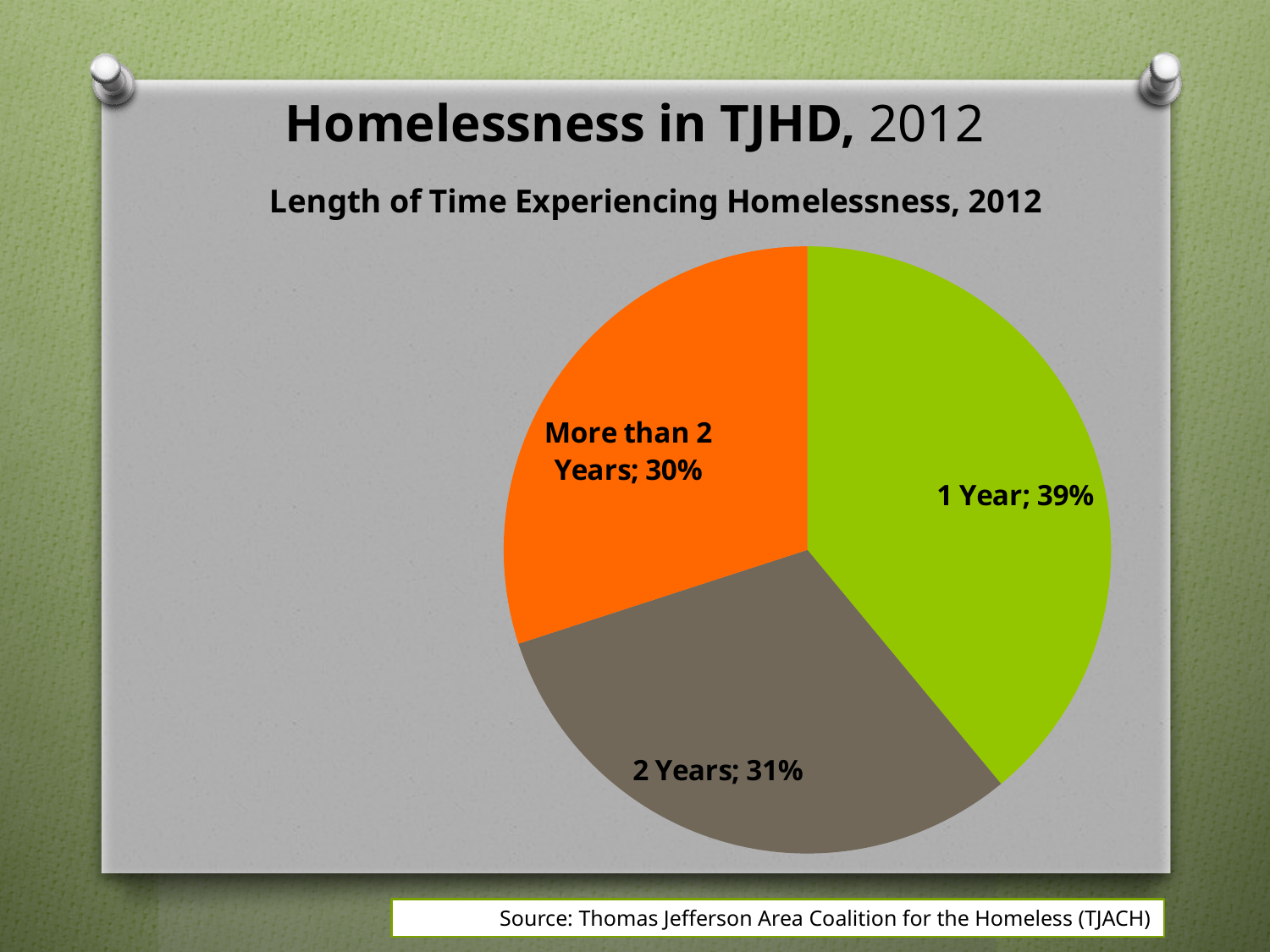
What is the difference in percentage points between the "1 Year" slice and the "More than 2 Years" slice? 9 Which category has the smallest slice of the pie? More than 2 Years What share of the pie is labelled "2 Years"? 31% Which is larger, the "1 Year" slice or the "2 Years" slice? 1 Year What share of the pie is labelled "More than 2 Years"? 30% What is the difference in percentage points between the "1 Year" slice and the "2 Years" slice? 8 Which category has the largest slice of the pie? 1 Year What kind of chart is shown on the slide? Pie chart What is the title of the chart? Length of Time Experiencing Homelessness, 2012 What colour is the "2 Years" slice? Grey How many slices does the pie chart have? 3 What share of the pie is labelled "1 Year"? 39%